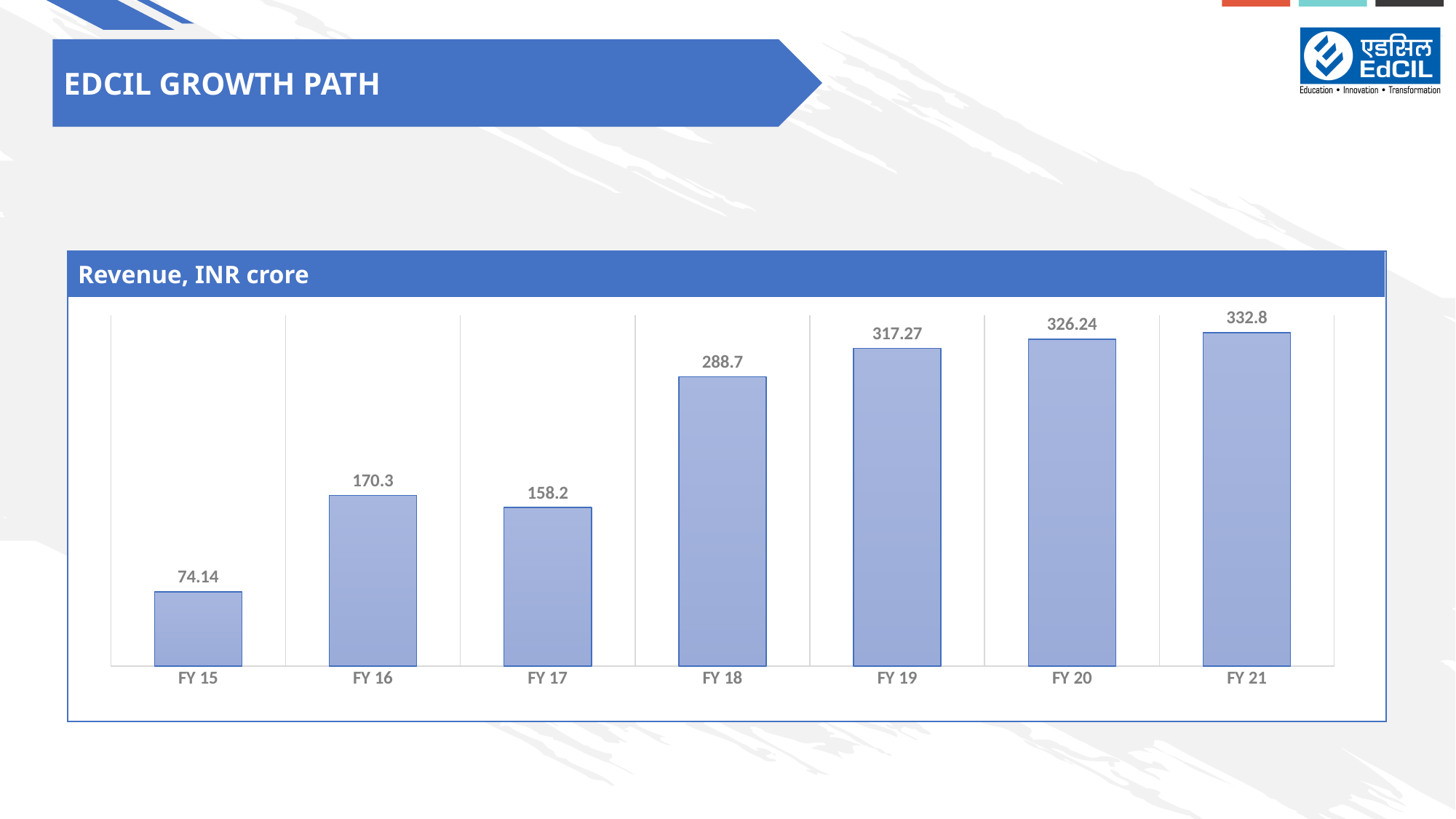
Which has higher revenue, FY 16 or FY 17? FY 16 What is the difference in revenue between FY 21 and FY 15? 258.66 Which fiscal year has the highest revenue? FY 21 Which fiscal year has the lowest revenue? FY 15 How many fiscal years are shown in the chart? 7 What is the difference in revenue between FY 16 and FY 17? 12.1 What kind of chart is shown on the slide? Bar chart What is the revenue for FY 20? 326.24 What is the revenue for FY 15? 74.14 What is the title of the chart? Revenue, INR crore What is the revenue for FY 18? 288.7 Does revenue generally rise or fall from FY 15 to FY 21? Rise